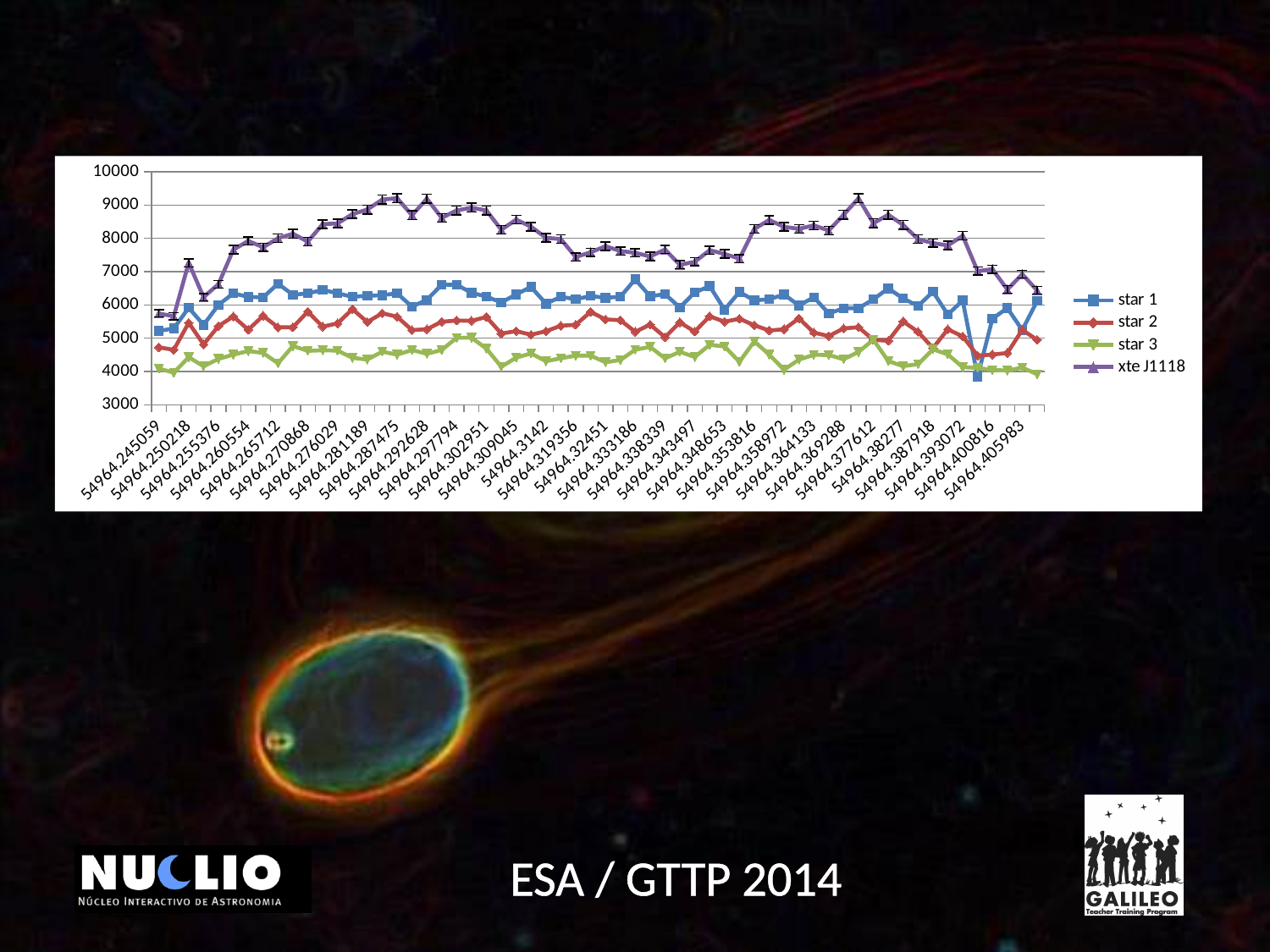
How many series does the legend list? 4 Is the value for star 3 at 54964.245059 greater or less than 5000? less Does the xte J1118 series rise or fall between 54964.245059 and 54964.287475? rise Is the value for xte J1118 at 54964.287475 greater or less than 8000? greater What is the highest value shown on the vertical axis? 10000 Is the value for star 2 at 54964.245059 greater or less than 5000? less Which series is drawn in purple? xte J1118 Which series has the highest values across the chart? xte J1118 What kind of chart is shown on the slide? line chart At 54964.287475, which is larger: the value for xte J1118 or the value for star 1? xte J1118 Which series has the lowest values across the chart? star 3